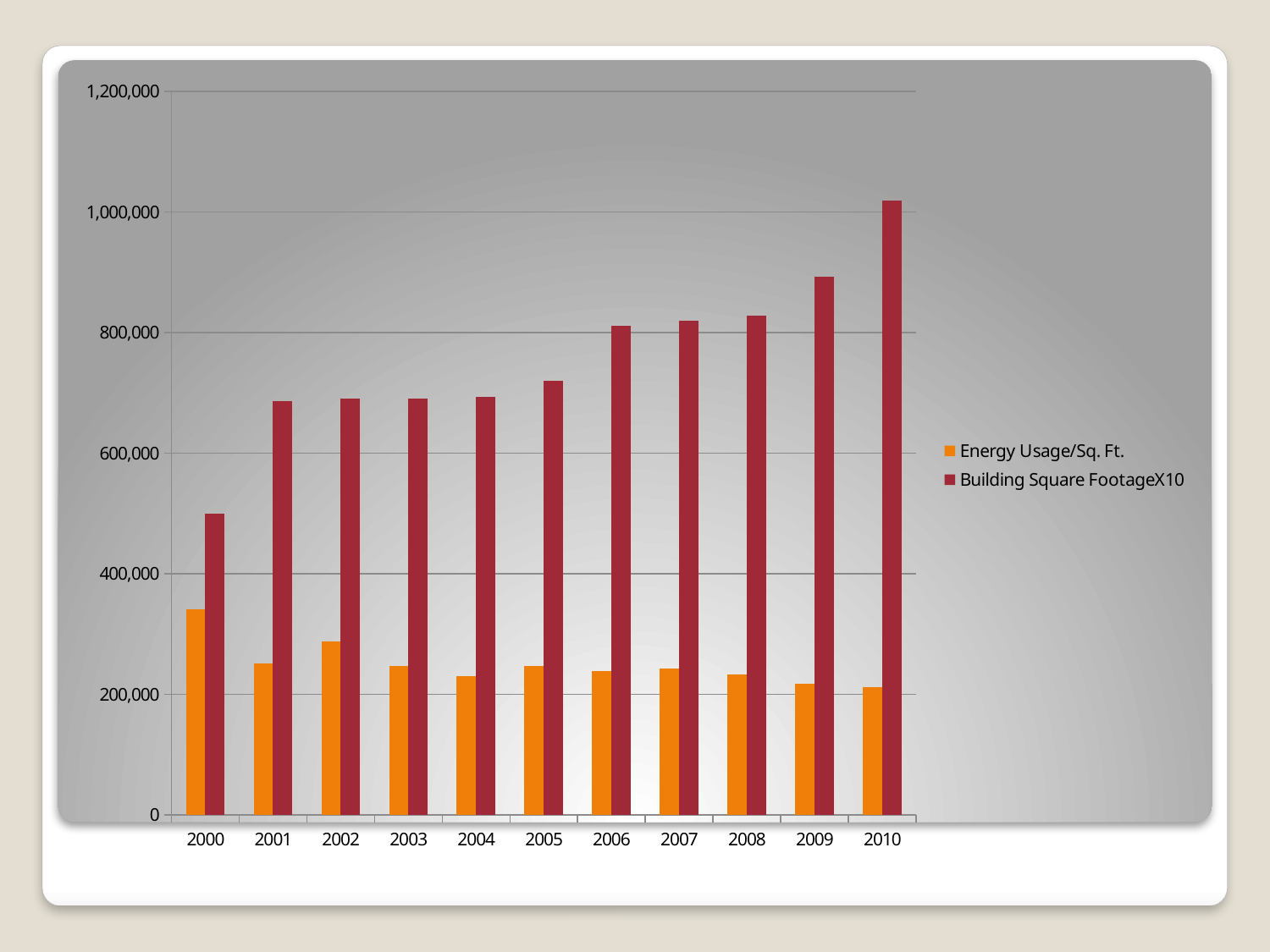
Is the value for Building Square FootageX10 in 2010 greater or less than 1,000,000? greater How many series does the legend list? 2 Does Building Square FootageX10 generally rise or fall from 2000 to 2010? Rise In which year is Energy Usage/Sq. Ft. highest? 2000 In which year is Building Square FootageX10 lowest? 2000 What kind of chart is shown on the slide? Bar chart Is the value for Energy Usage/Sq. Ft. in 2000 greater or less than 400,000? less Is the value for Building Square FootageX10 in 2000 greater or less than 600,000? less Which year has the larger Energy Usage/Sq. Ft. value, 2001 or 2002? 2002 In which year is Building Square FootageX10 highest? 2010 How many years are shown on the x axis? 11 Which year has the larger Building Square FootageX10 value, 2008 or 2009? 2009